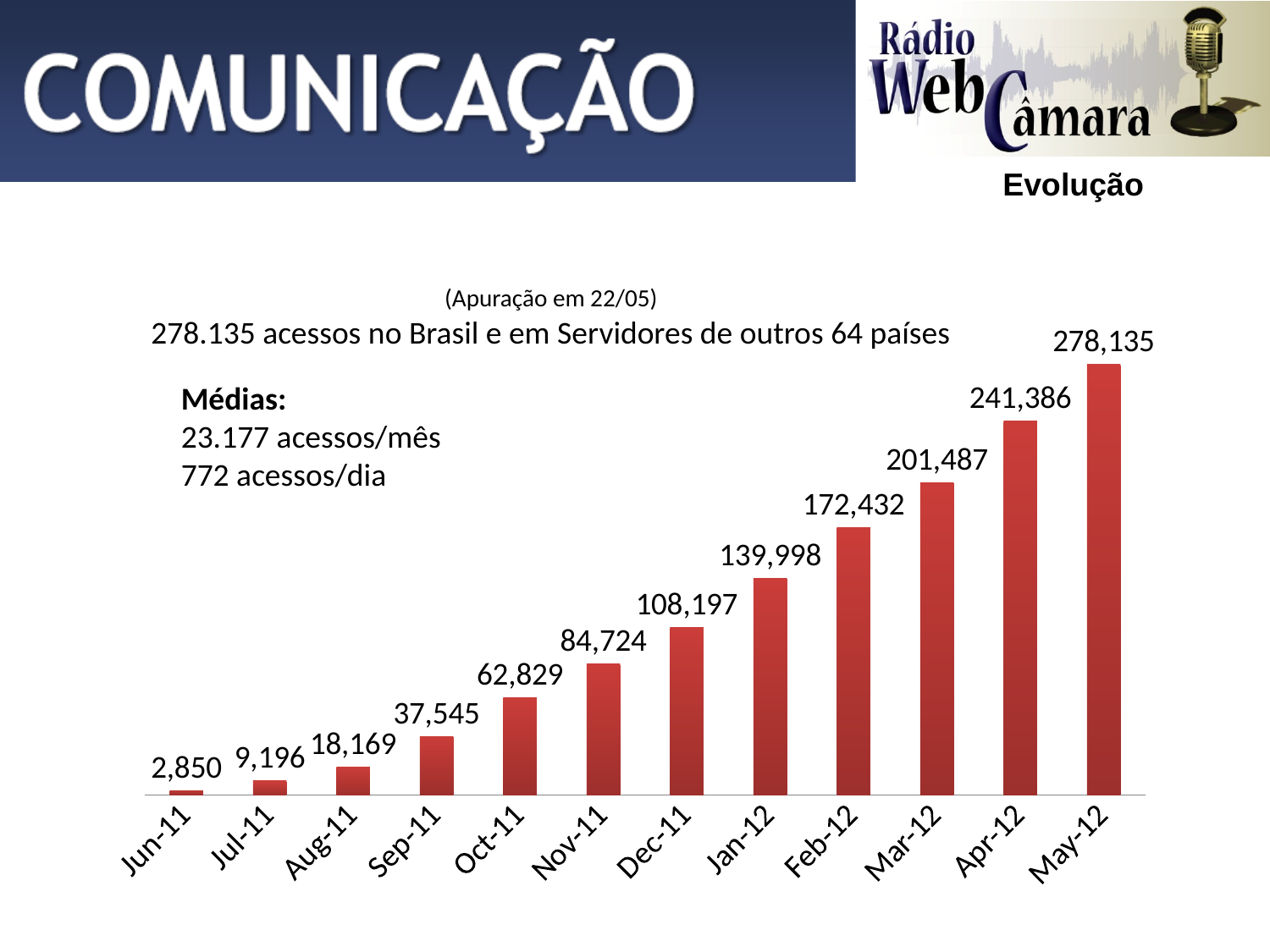
What is the difference between the values for May-12 and Apr-12? 36,749 Which month has the lowest value? Jun-11 What is the difference between the values for Sep-11 and Aug-11? 19,376 Which month has the highest value? May-12 How many months are shown on the x axis? 12 What is the value for Dec-11? 108,197 What is the value for Mar-12? 201,487 What colour are the bars in the chart? red What kind of chart is this? bar chart What is the value for Jun-11? 2,850 Which is larger, the value for Oct-11 or the value for Nov-11? Nov-11 Do the values rise or fall from Jun-11 to May-12? rise